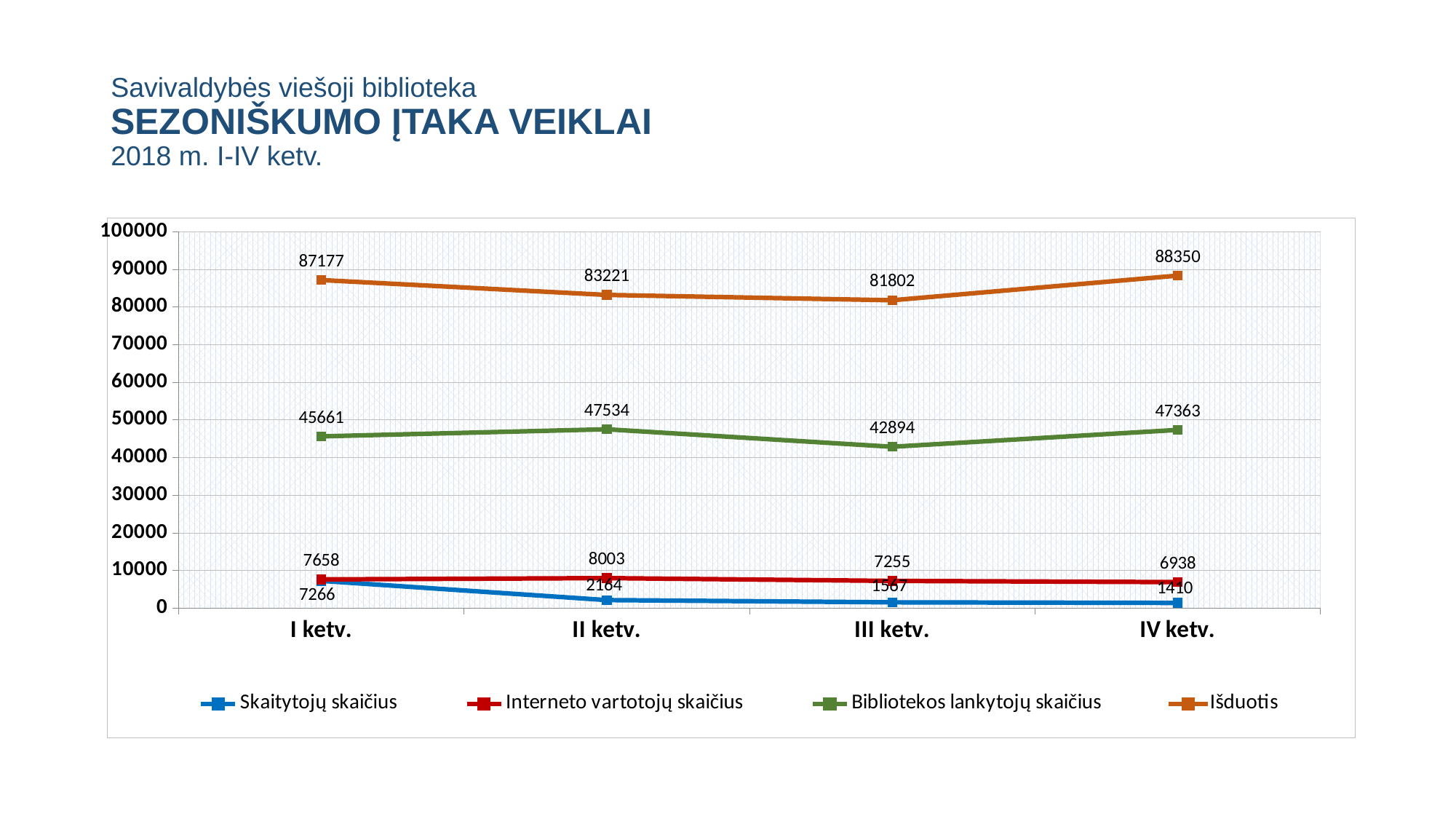
Which is larger: Interneto vartotojų skaičius in I ketv. or in IV ketv.? I ketv. In which quarter is Išduotis lowest? III ketv. How many series does the legend list? 4 What is the difference between Išduotis in IV ketv. and in III ketv.? 6548 What is the value of Skaitytojų skaičius in I ketv.? 7266 In which quarter is Bibliotekos lankytojų skaičius highest? II ketv. What is the value of Interneto vartotojų skaičius in II ketv.? 8003 What is the value of Išduotis in IV ketv.? 88350 Is the value of Bibliotekos lankytojų skaičius in II ketv. greater or less than 40000? greater How many quarters (categories) are plotted on the x axis? 4 What kind of chart is shown on the slide? line chart What is the value of Bibliotekos lankytojų skaičius in III ketv.? 42894